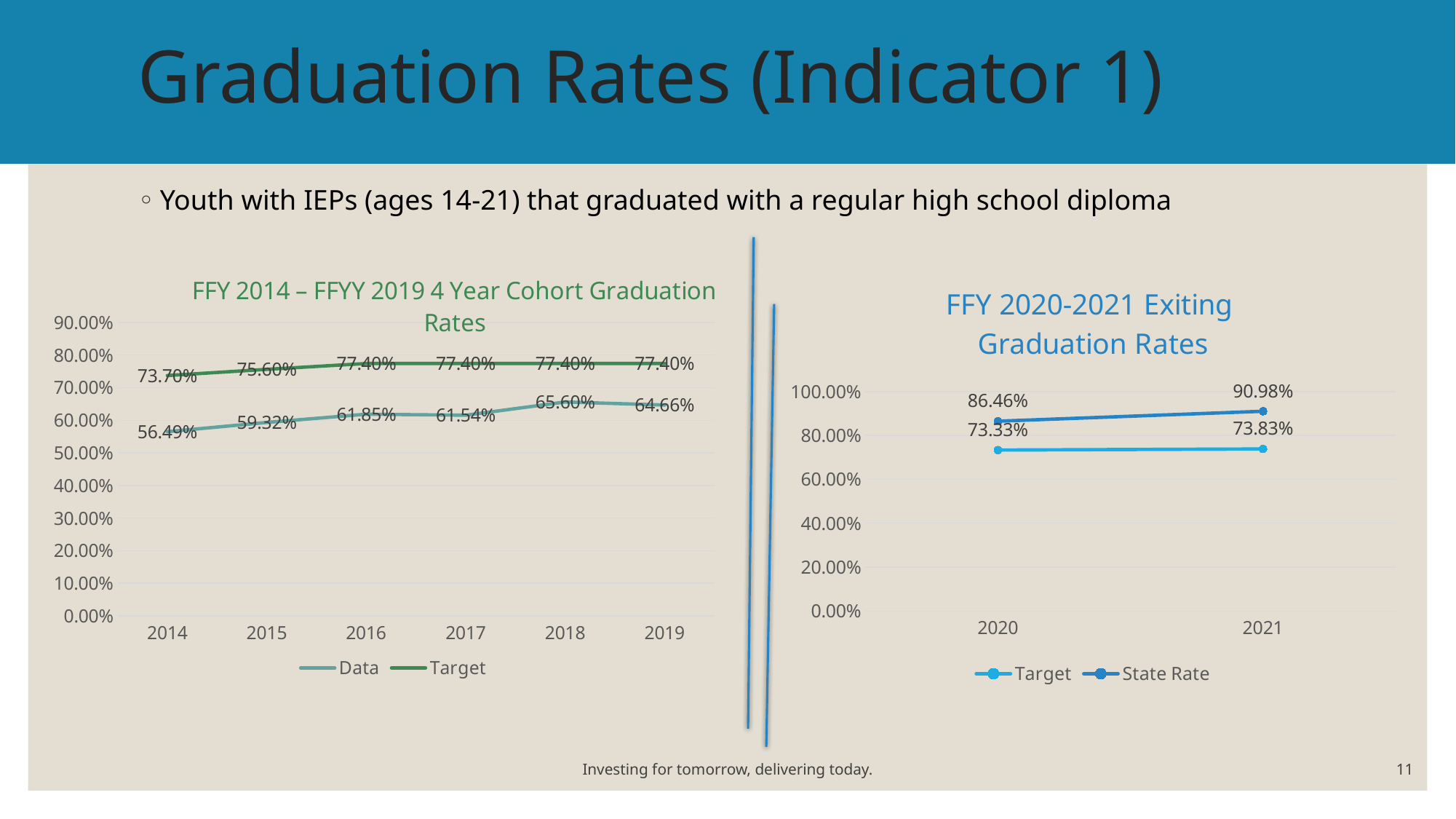
What type of chart is the FFY 2020-2021 Exiting Graduation Rates chart? Line chart In the FFY 2020-2021 Exiting Graduation Rates chart, what is the Target value for 2020? 73.33% In the FFY 2020-2021 Exiting Graduation Rates chart, what is the State Rate for 2021? 90.98% In the FFY 2014 – FFYY 2019 4 Year Cohort Graduation Rates chart, how many series does the legend list? 2 In the FFY 2020-2021 Exiting Graduation Rates chart, which is larger in 2020, the Target or the State Rate? State Rate In the FFY 2014 – FFYY 2019 4 Year Cohort Graduation Rates chart, which year has the lowest Data value? 2014 In the FFY 2020-2021 Exiting Graduation Rates chart, does the State Rate rise or fall from 2020 to 2021? Rise In the FFY 2014 – FFYY 2019 4 Year Cohort Graduation Rates chart, which year has the highest Data value? 2018 In the FFY 2014 – FFYY 2019 4 Year Cohort Graduation Rates chart, what is the difference between the Target and Data values for 2019? 12.74% In the FFY 2014 – FFYY 2019 4 Year Cohort Graduation Rates chart, what is the Target value for 2014? 73.70% In the FFY 2014 – FFYY 2019 4 Year Cohort Graduation Rates chart, what is the Data value for 2016? 61.85% In the FFY 2014 – FFYY 2019 4 Year Cohort Graduation Rates chart, how many years are shown on the x axis? 6